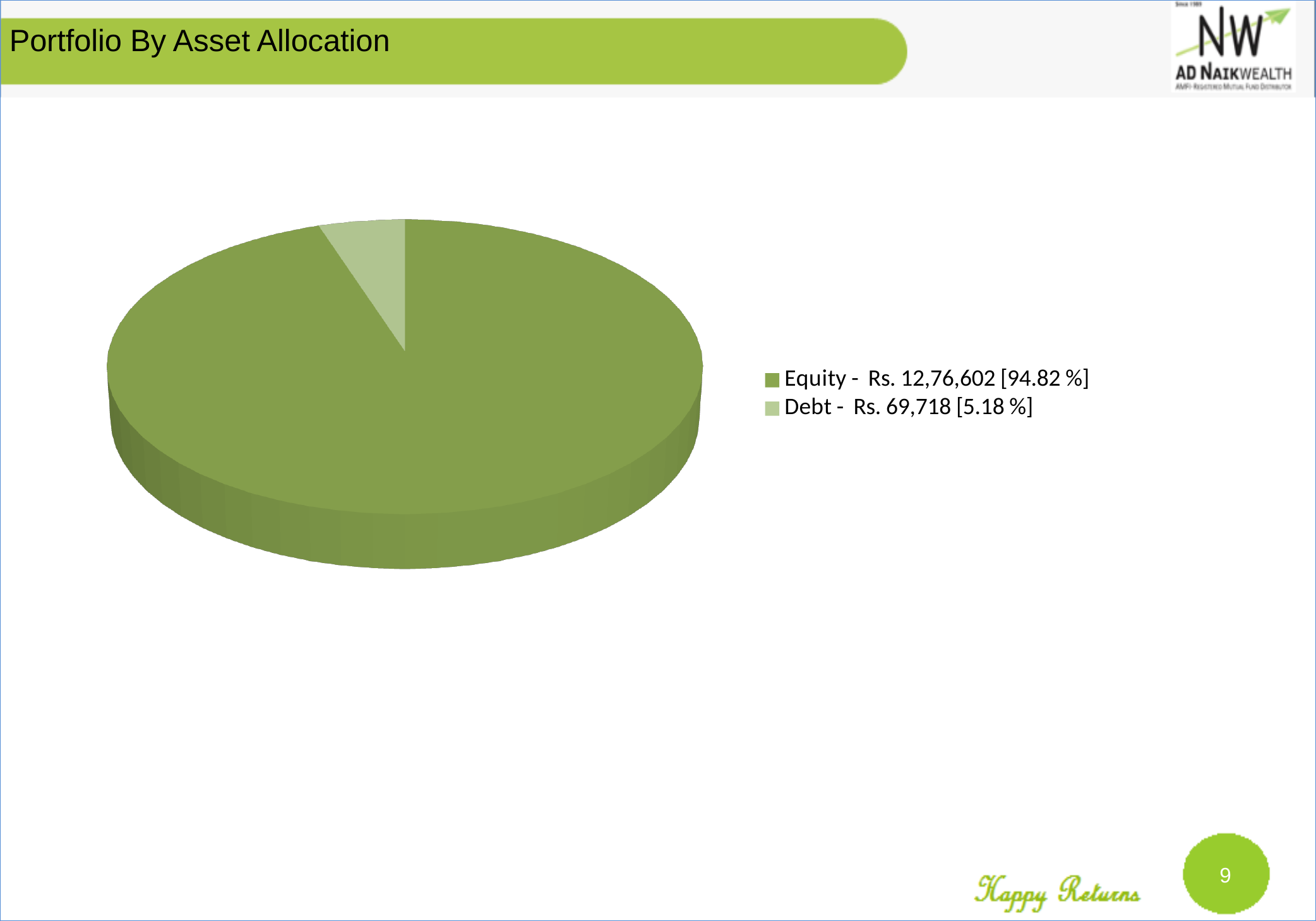
What is the value for Debt? Rs. 69,718 What share of the pie does Equity represent? 94.82 % What share of the pie does Debt represent? 5.18 % Which asset class has the smallest slice of the pie? Debt What kind of chart is shown on the slide? Pie chart Which asset class has the largest slice of the pie? Equity What is the value for Equity? Rs. 12,76,602 Which legend entry is shown in the lighter green colour? Debt What is the difference in value between Equity and Debt? Rs. 12,06,884 What is the title of the slide containing the chart? Portfolio By Asset Allocation How many slices does the pie chart have? 2 Which is larger, Equity or Debt? Equity